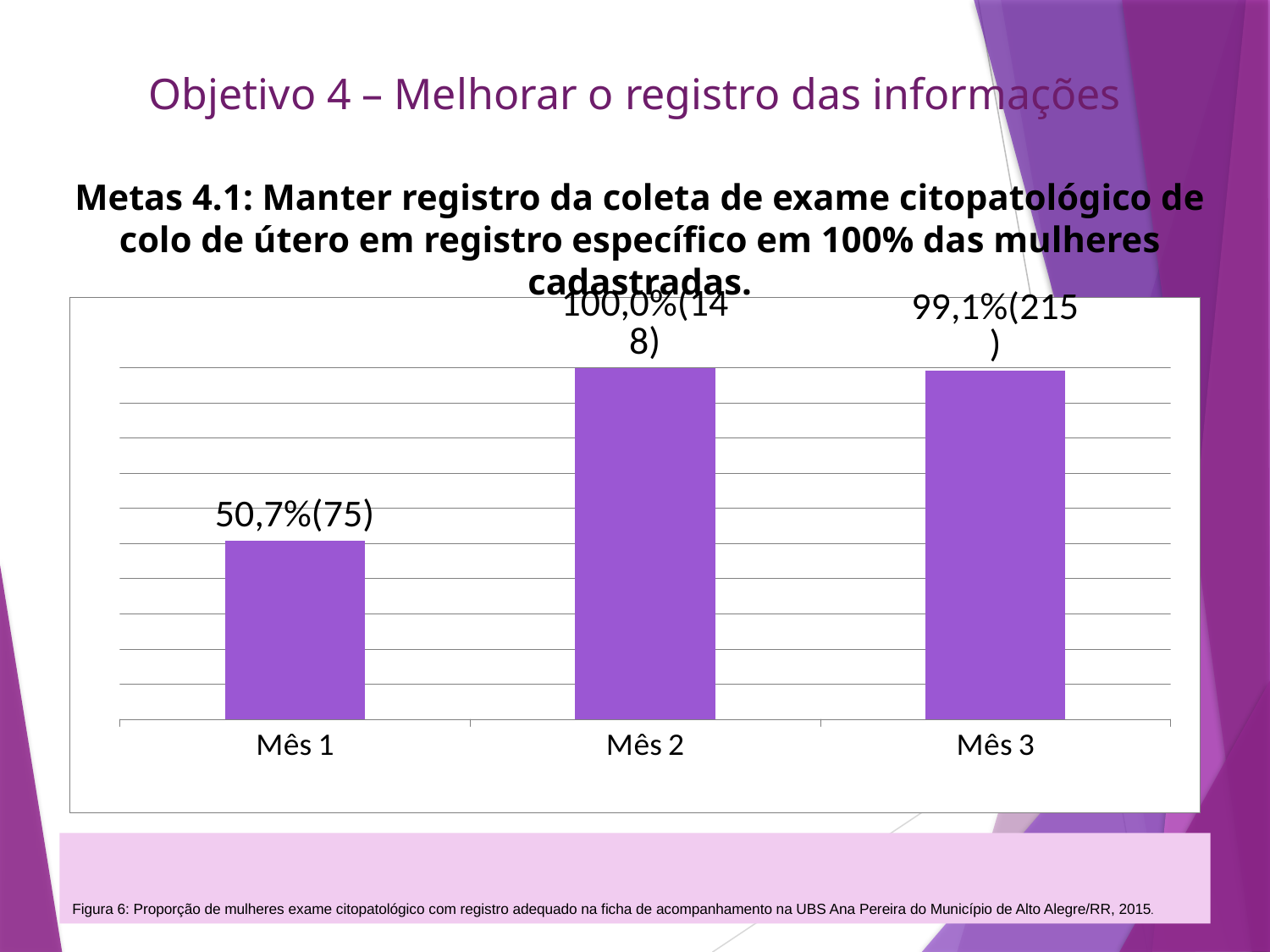
What is the value shown for Mês 1? 50,7%(75) Which month has the lowest percentage? Mês 1 How many more women are counted in Mês 3 than in Mês 1 (numbers in parentheses)? 140 What kind of chart is shown on the slide? Bar chart How many months (categories) are shown on the x axis? 3 What is the value shown for Mês 2? 100,0%(148) What is the difference in percentage between Mês 2 and Mês 1? 49,3 percentage points Which month has the highest percentage? Mês 2 Which is larger, the percentage for Mês 1 or for Mês 3? Mês 3 What is the difference in percentage between Mês 2 and Mês 3? 0,9 percentage points What is the value shown for Mês 3? 99,1%(215) Does the percentage rise or fall from Mês 1 to Mês 2? Rise